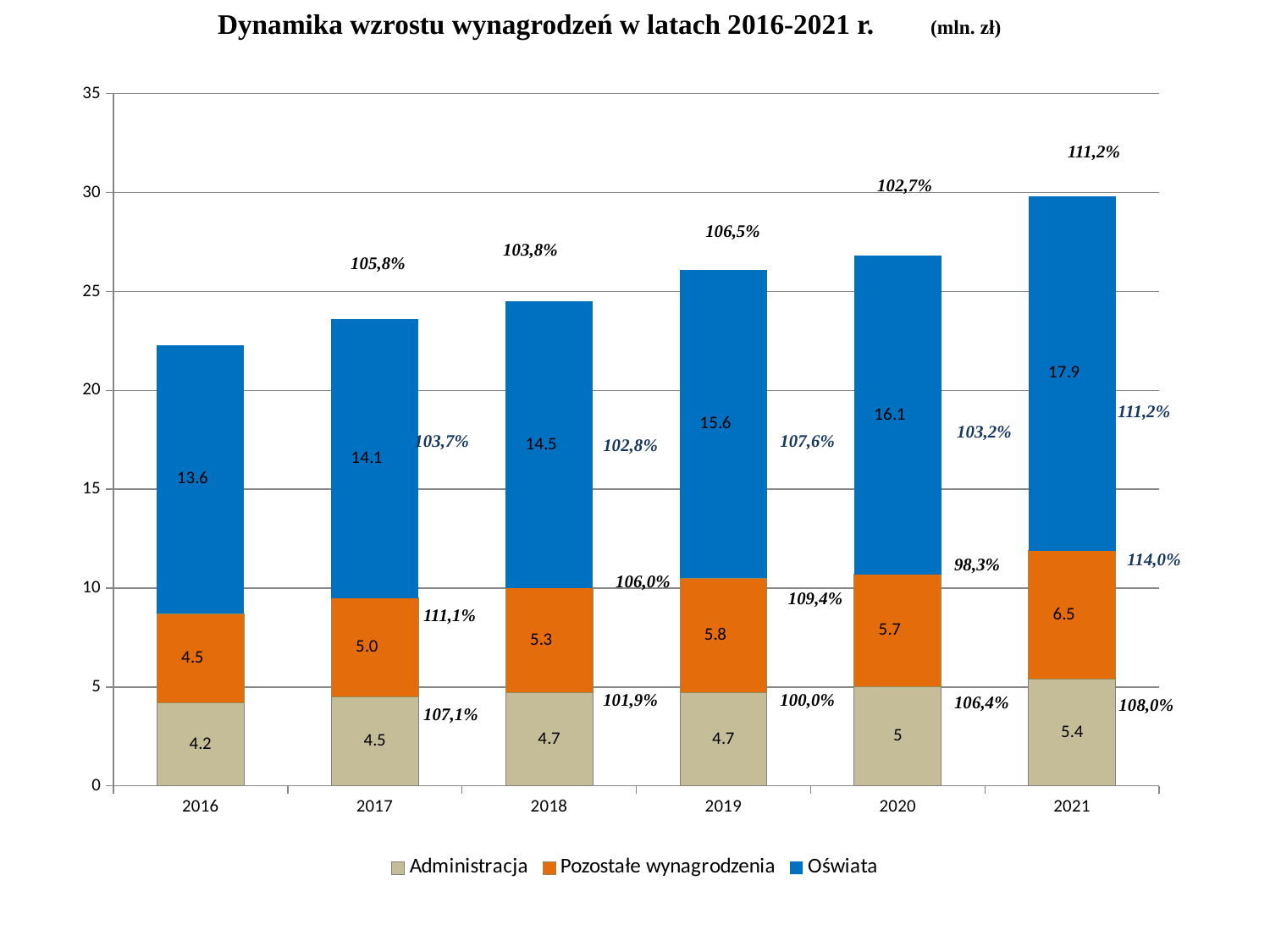
Do the Oświata values rise or fall from 2016 to 2021? rise What is the total of the stacked bar for 2021? 29.8 What type of chart is shown on the slide? stacked bar chart What is the value for Pozostałe wynagrodzenia in 2017? 5.0 What is the value for Oświata in 2019? 15.6 What is the value for Administracja in 2021? 5.4 How many series does the legend list? 3 What is the difference between the Oświata values in 2021 and 2016? 4.3 In which year is the Administracja value lowest? 2016 How many years are shown on the x axis? 6 In which year is the Oświata value highest? 2021 Which is larger: Pozostałe wynagrodzenia in 2020 or in 2019? 2019